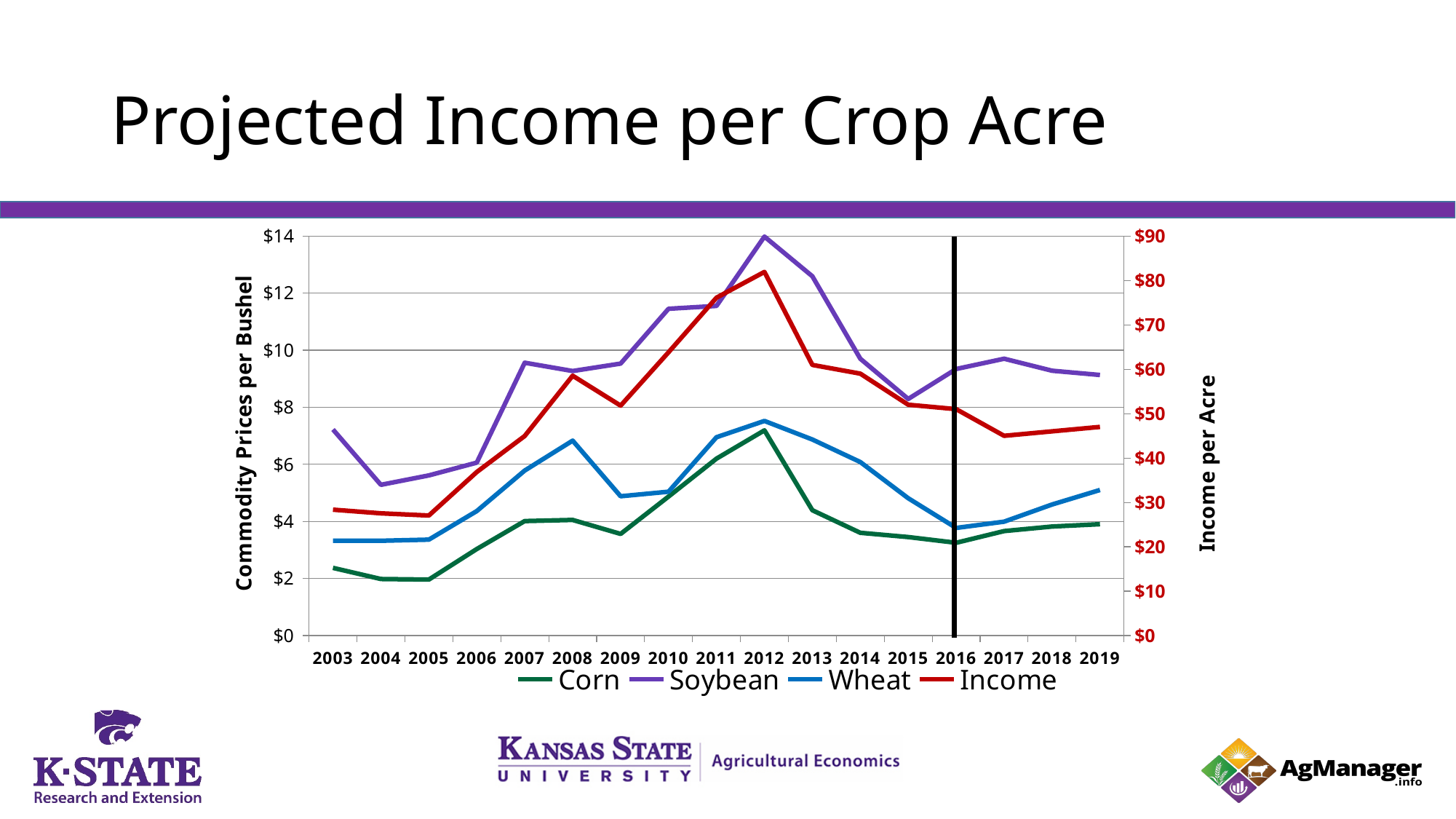
Does the Income line rise or fall from 2012 to 2017? Fall How many years are shown along the x axis of the chart? 17 In which year does the Income line reach its highest value? 2012 What is the title of the left vertical axis? Commodity Prices per Bushel Is the Income value for 2017 greater or less than $50 on the right axis? less Is the Corn value for 2003 greater or less than $4? less Is the Wheat value for 2012 greater or less than $6? greater How many series does the chart's legend list? 4 In which year does the Soybean line reach its highest value? 2012 What kind of chart is shown on the slide? Line chart In 2008, which is larger, the Soybean value or the Wheat value? Soybean